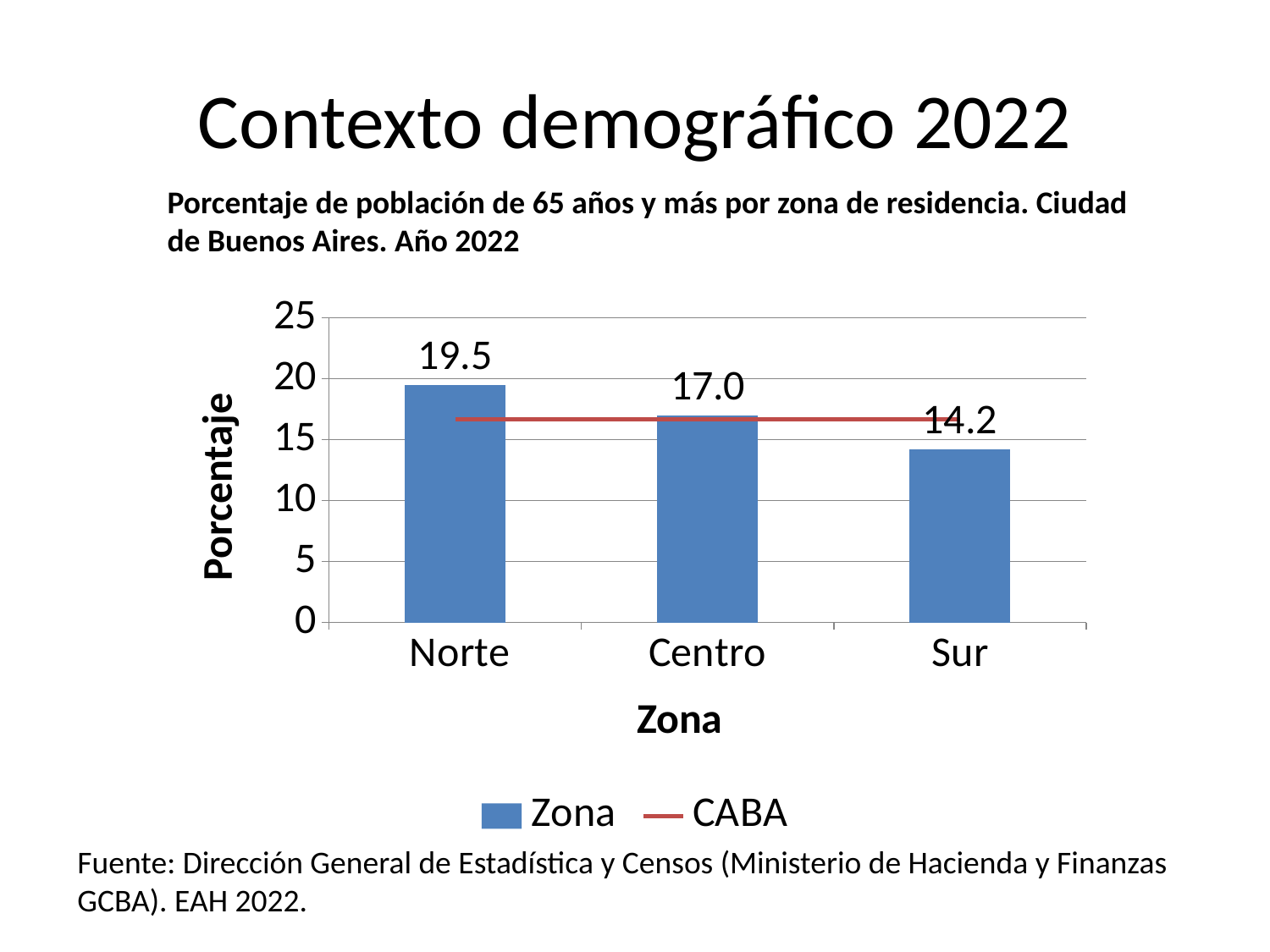
What is the value for Sur? 14.2 Which is larger, the value for Centro or the value for Sur? Centro Which zone has the highest percentage? Norte What is the label of the y axis? Porcentaje What is the value for Centro? 17.0 What is the value for Norte? 19.5 What is the difference between the values for Norte and Centro? 2.5 What is the difference between the values for Norte and Sur? 5.3 Is the CABA line value greater or less than 15? greater How many zones are shown on the x axis? 3 Which zone has the lowest percentage? Sur How many series does the legend list? 2